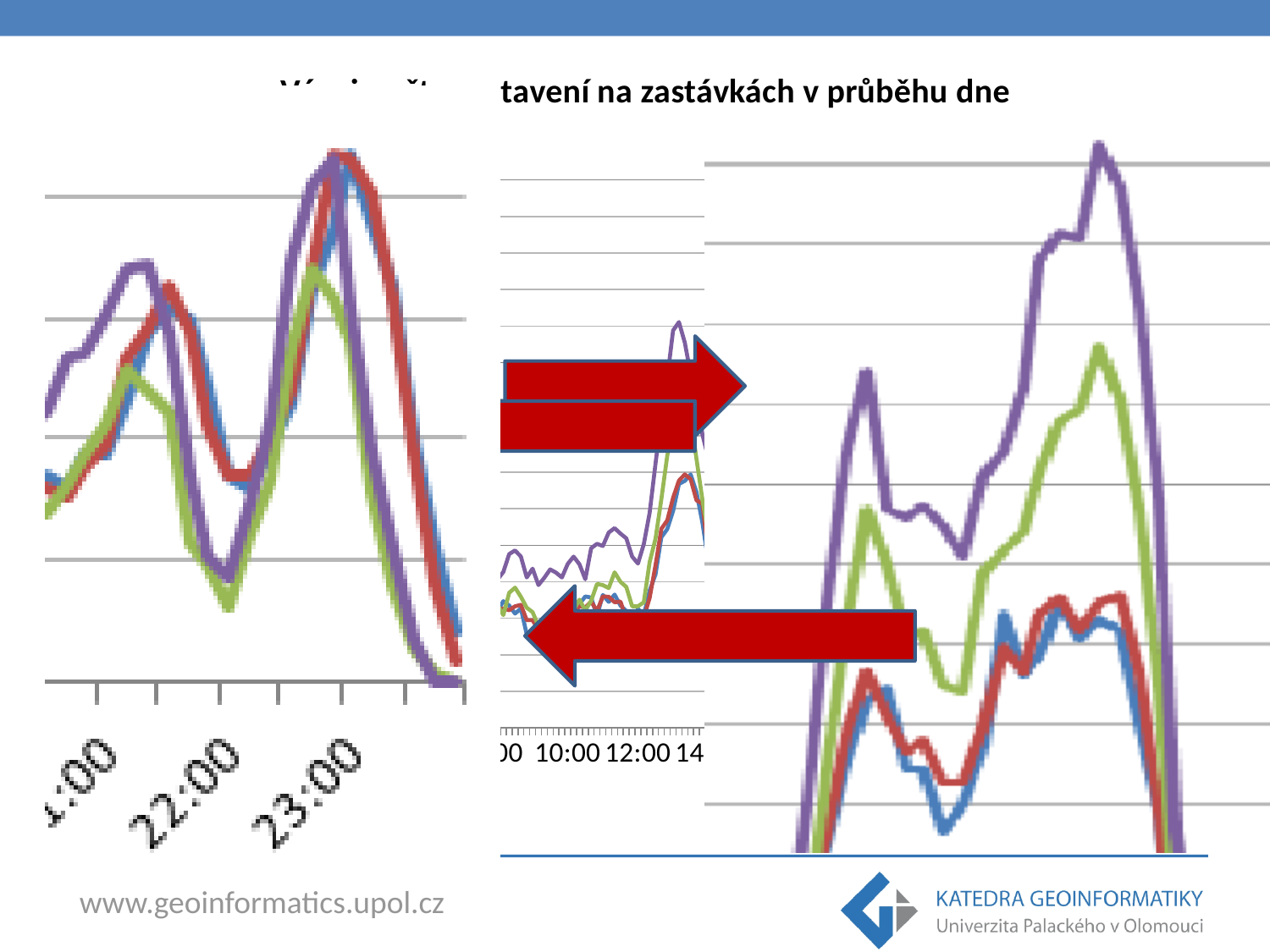
Which time labels are readable on the x axis of the left-hand zoomed chart? 22:00 and 23:00 What kind of chart is shown on the slide? line chart In the left-hand zoomed chart, do the lines rise or fall after the last peak near 23:00? fall How many coloured lines are plotted in the chart? 4 In the right-hand zoomed chart, which line peaks higher, the green line or the purple line? purple In the right-hand zoomed chart, which coloured line reaches the highest peak? purple In the right-hand zoomed chart, which line is higher at its peak, the green line or the red line? green